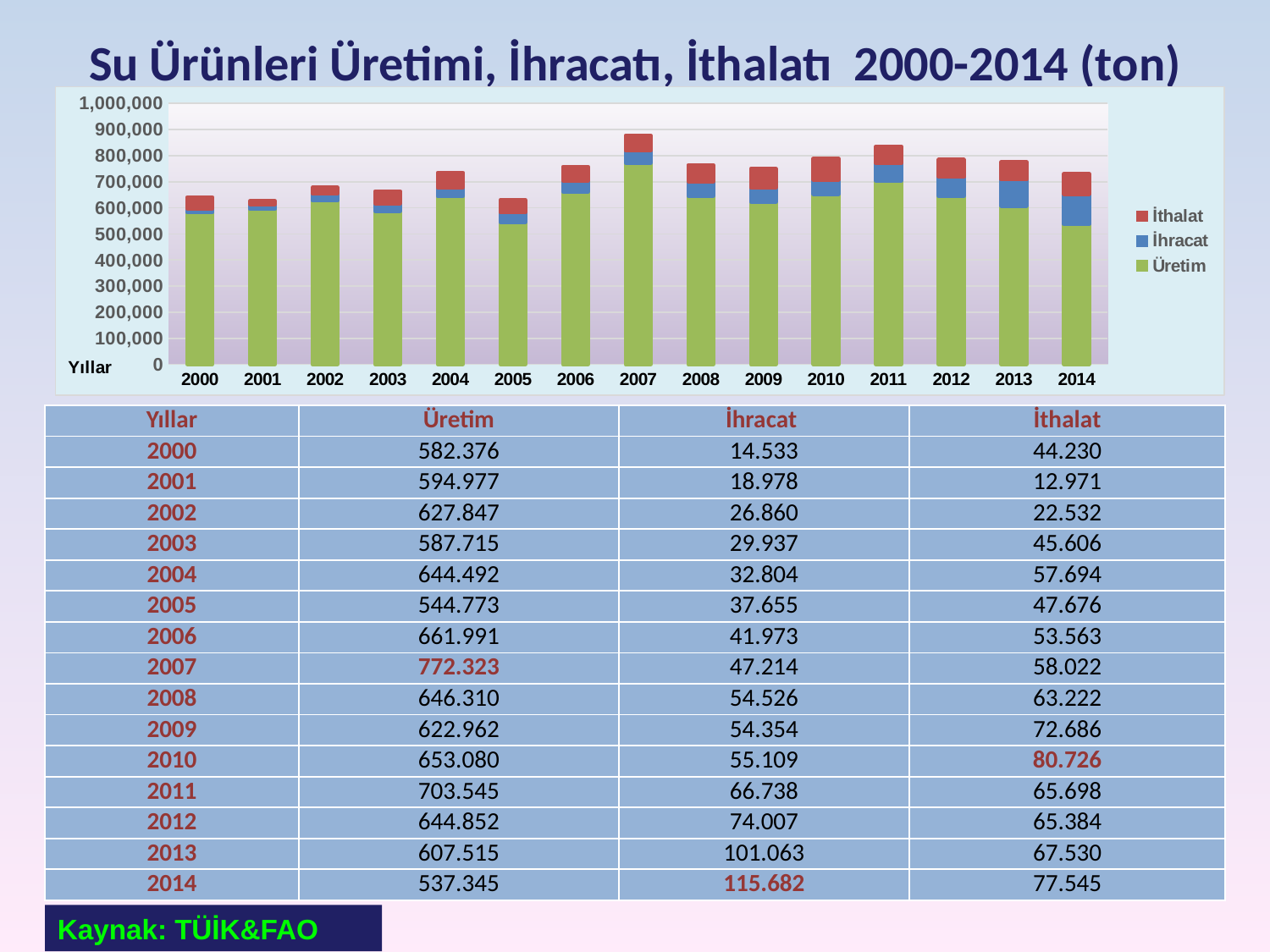
How many series does the chart legend list? 3 What is the İthalat value for 2001? 12.971 Which year has the lowest Üretim value? 2014 Which year has the highest İthalat value? 2010 What is the difference between the İhracat values for 2014 and 2013? 14.619 What kind of chart is shown on the slide? Stacked bar chart Which is larger, the İthalat value for 2000 or for 2001? 2000 What is the total of the stacked bar for 2007 (Üretim + İhracat + İthalat)? 877.559 What is the İhracat value for 2014? 115.682 What is the Üretim value for 2007? 772.323 How many years are shown on the x axis of the chart? 15 Which year has the highest Üretim value? 2007